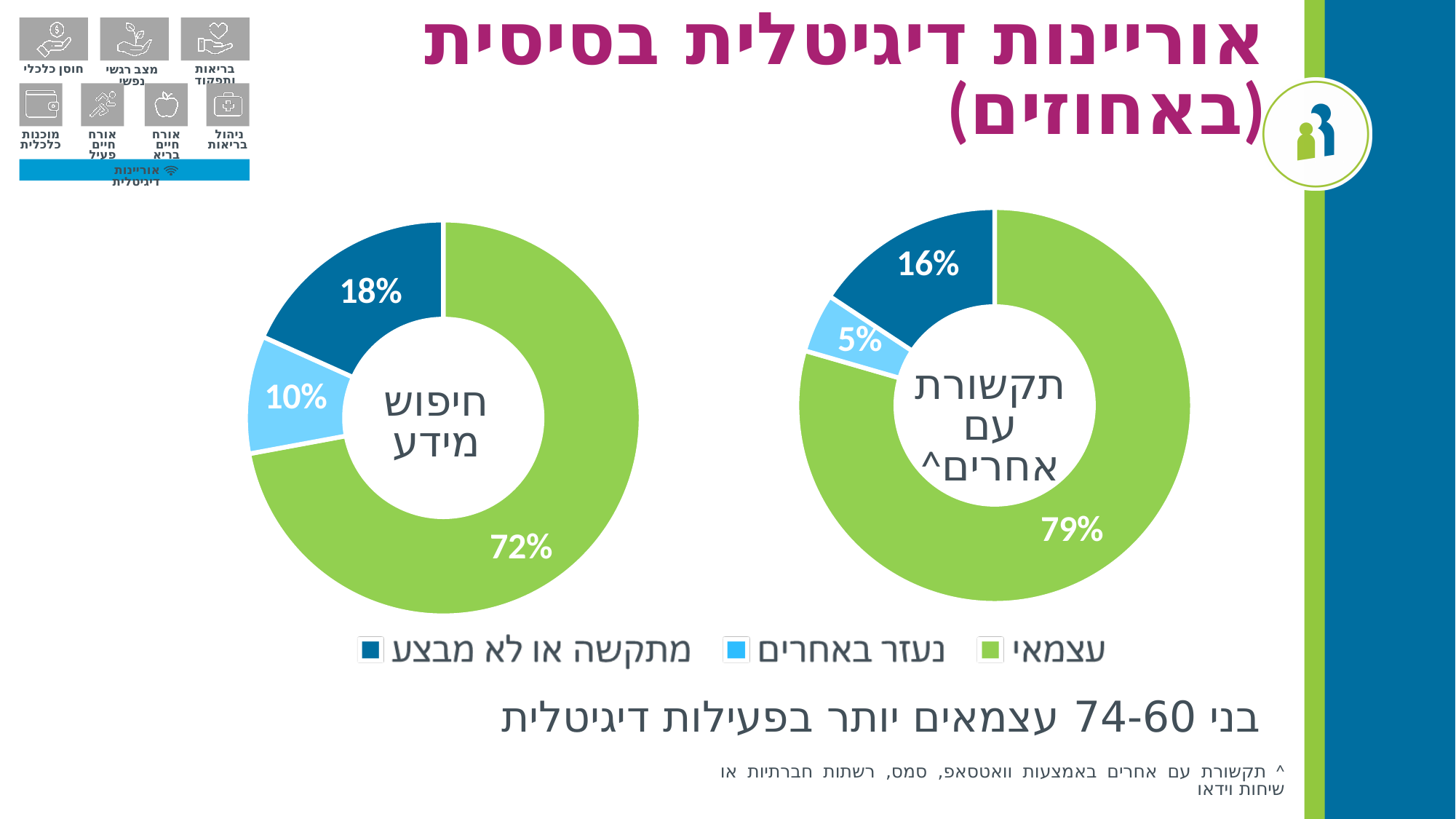
In the "חיפוש מידע" chart, which category has the smallest share? נעזר באחרים Which colour represents "נעזר באחרים" in the legend? Light blue What type of chart is the "תקשורת עם אחרים" chart? Donut (pie) chart How many slices does the "חיפוש מידע" chart have? 3 What is the difference between the "עצמאי" share in the "תקשורת עם אחרים" chart and the "עצמאי" share in the "חיפוש מידע" chart? 7% In the "חיפוש מידע" chart, what percentage is shown for "מתקשה או לא מבצע"? 18% How many entries does the shared legend list? 3 Which is larger: "מתקשה או לא מבצע" in the "חיפוש מידע" chart or "מתקשה או לא מבצע" in the "תקשורת עם אחרים" chart? חיפוש מידע In the "חיפוש מידע" chart, what percentage is shown for "עצמאי"? 72% In the "תקשורת עם אחרים" chart, what percentage is shown for "עצמאי"? 79% In the "תקשורת עם אחרים" chart, which category has the largest share? עצמאי In the "תקשורת עם אחרים" chart, what percentage is shown for "נעזר באחרים"? 5%